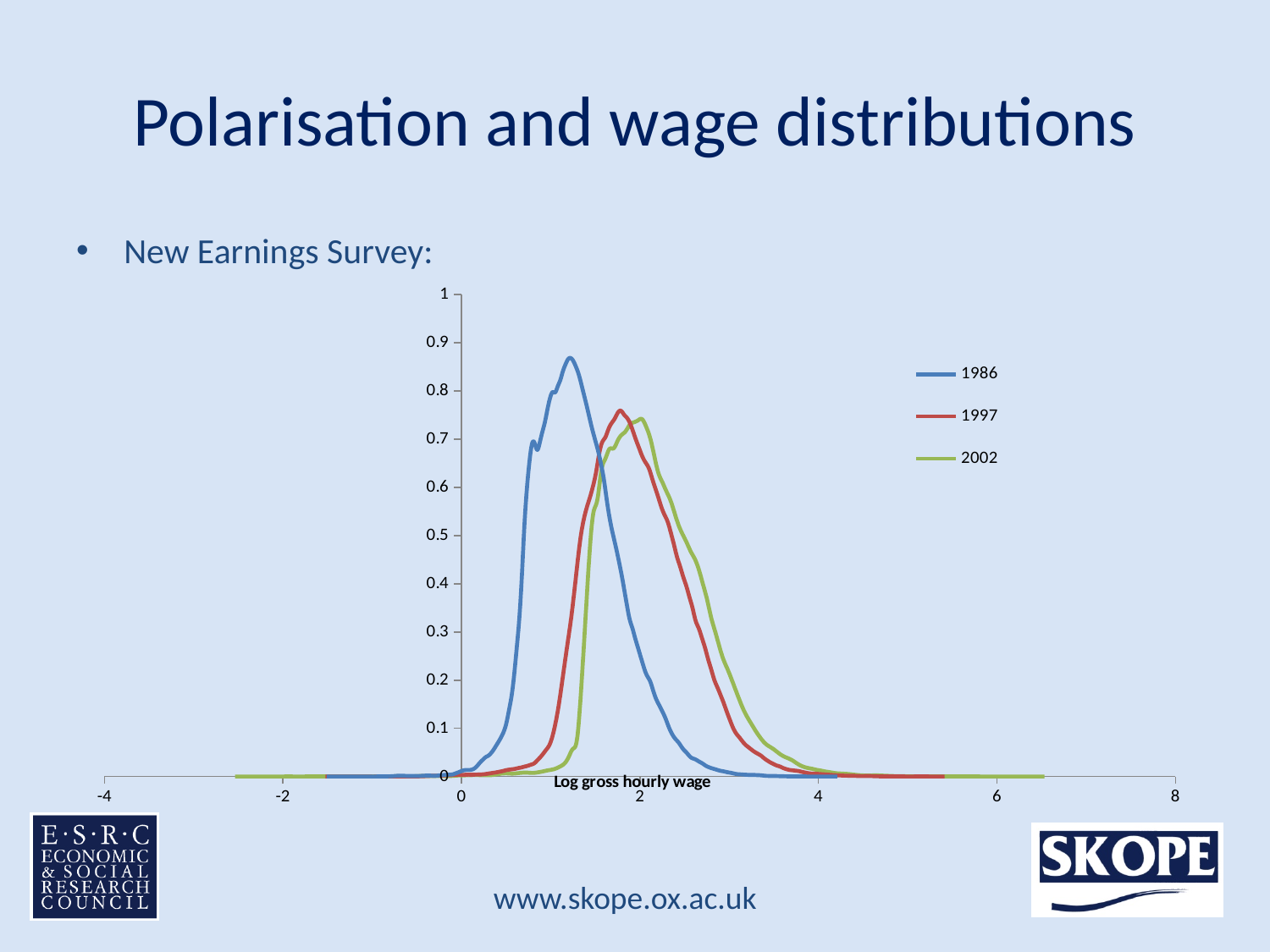
Is the peak value of the 1997 series greater or less than 0.8? less Which series has its peak furthest to the right along the x axis? 2002 Does the 1986 series rise or fall as the x axis moves from 2 to 3? fall Which series reaches the highest peak value? 1986 Which series has its peak furthest to the left along the x axis? 1986 Which years are listed in the chart legend? 1986, 1997, 2002 What kind of chart is shown on the slide? line chart How many series does the legend list? 3 Which has a higher peak, the 1986 series or the 1997 series? 1986 What is the title of the x axis? Log gross hourly wage Is the peak value of the 2002 series greater or less than 0.8? less Is the peak value of the 1986 series greater or less than 0.8? greater